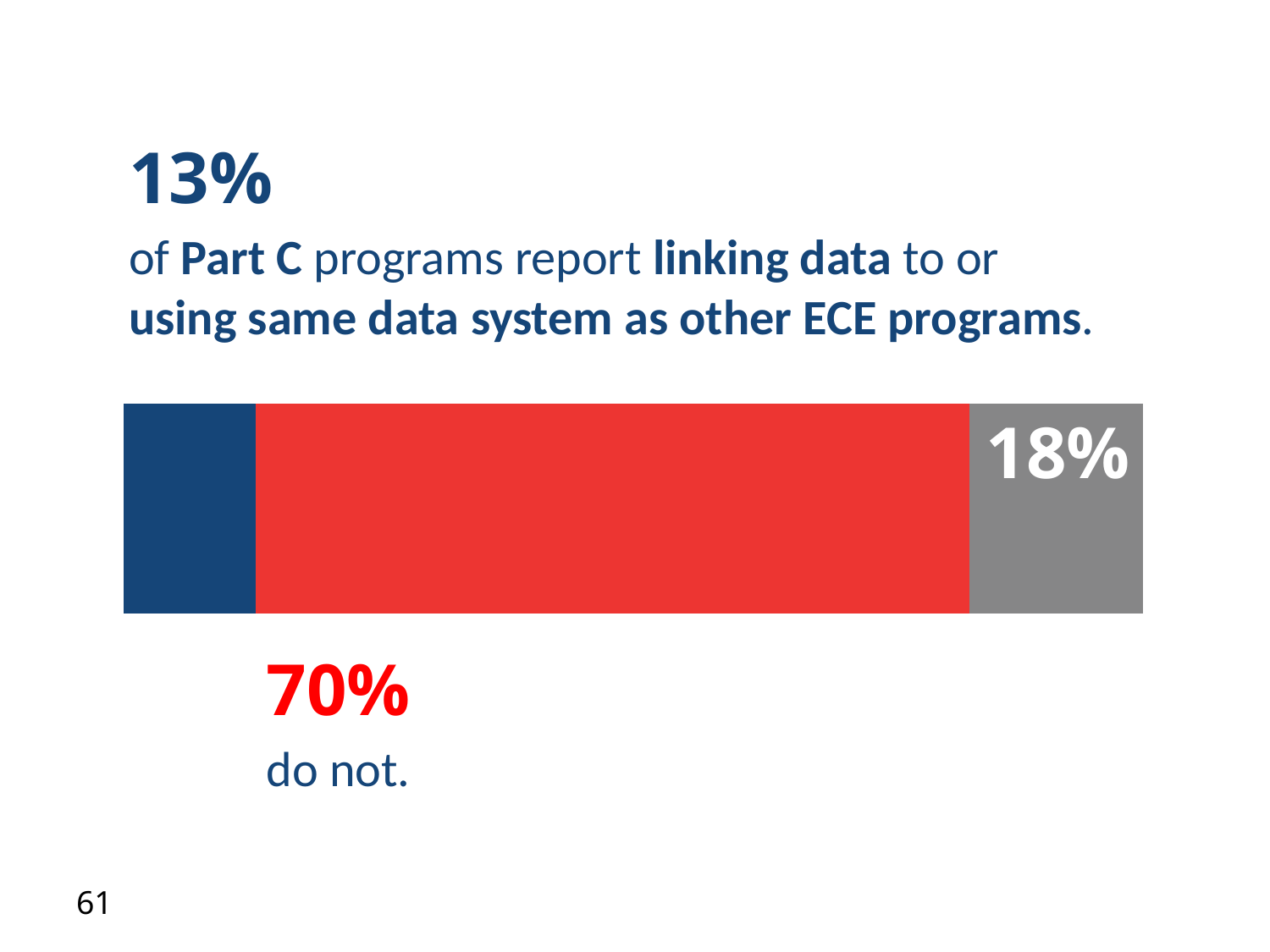
How many segments make up the bar? 3 What percentage of Part C programs report linking data to or using the same data system as other ECE programs? 13% What value is printed on the gray segment of the bar? 18% What colour is the segment representing the 70% of programs that do not link data? Red What is the difference in percentage points between the programs that do not link data (70%) and those that do (13%)? 57 percentage points Which segment of the bar has the smallest value? The blue segment (13%) Which is larger, the gray segment or the blue segment of the bar? The gray segment What is the difference in percentage points between the gray segment (18%) and the blue segment (13%)? 5 percentage points Is the value for the red segment greater or less than 50%? greater What percentage of Part C programs do not link data to or use the same data system as other ECE programs? 70% Which segment of the bar has the largest value? The red segment (70%) What kind of chart is shown on the slide? A stacked bar chart